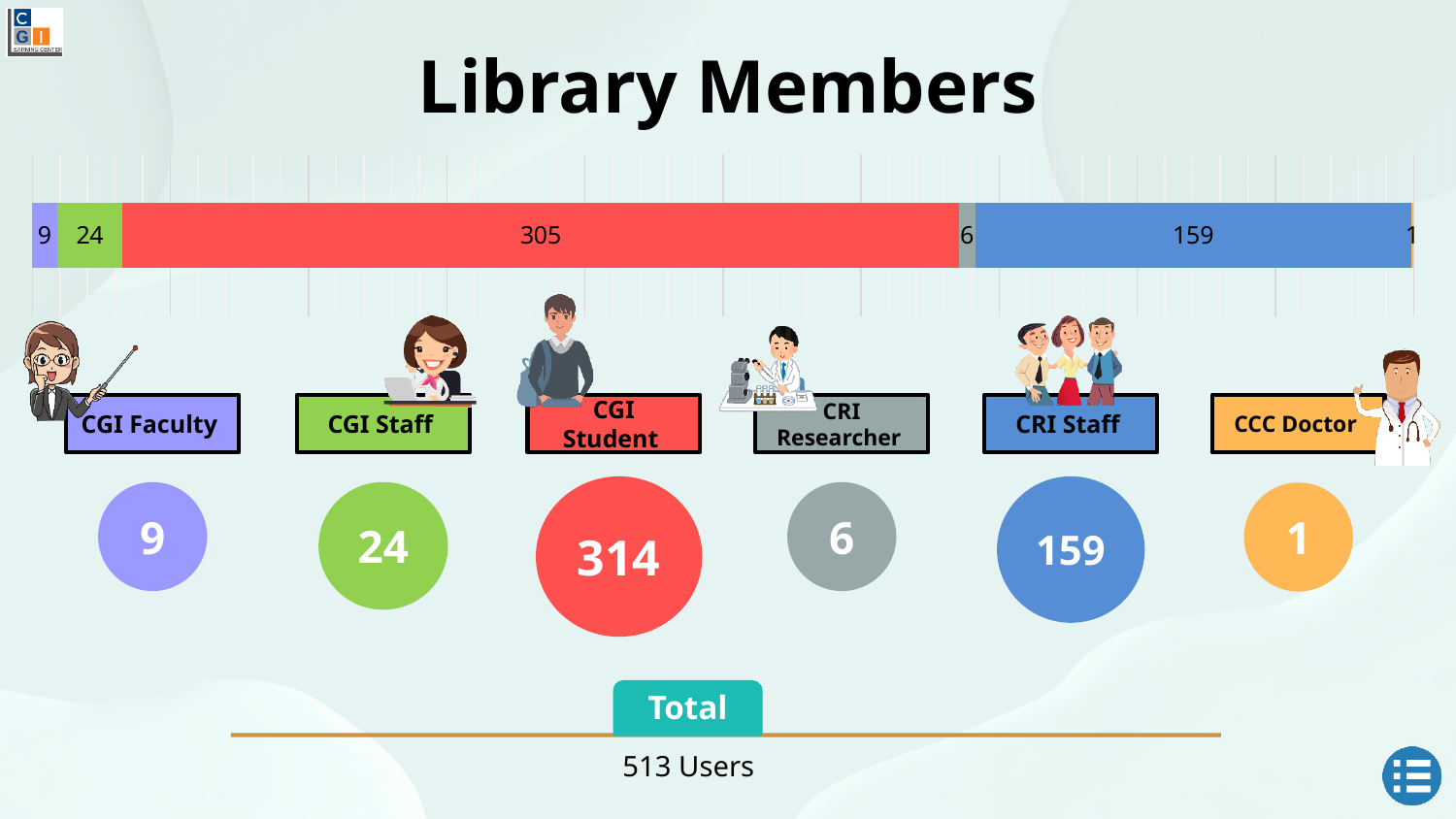
Which is larger in the bar chart, CRI Staff or CGI Staff? CRI Staff What is the title of the slide containing the chart? Library Members Which category has the largest segment in the stacked bar? CGI Student What colour is the CGI Student segment of the bar? red Which category has the smallest segment in the stacked bar? CCC Doctor What value is labelled on the CRI Researcher segment of the bar? 6 What value is labelled on the CRI Staff segment of the bar? 159 How many segments (categories) make up the stacked bar? 6 What value is labelled on the CGI Staff segment of the bar? 24 What value is labelled on the CGI Faculty segment of the bar? 9 What kind of chart is shown on the slide? stacked bar chart What is the difference between the CRI Staff value and the CGI Staff value in the bar chart? 135